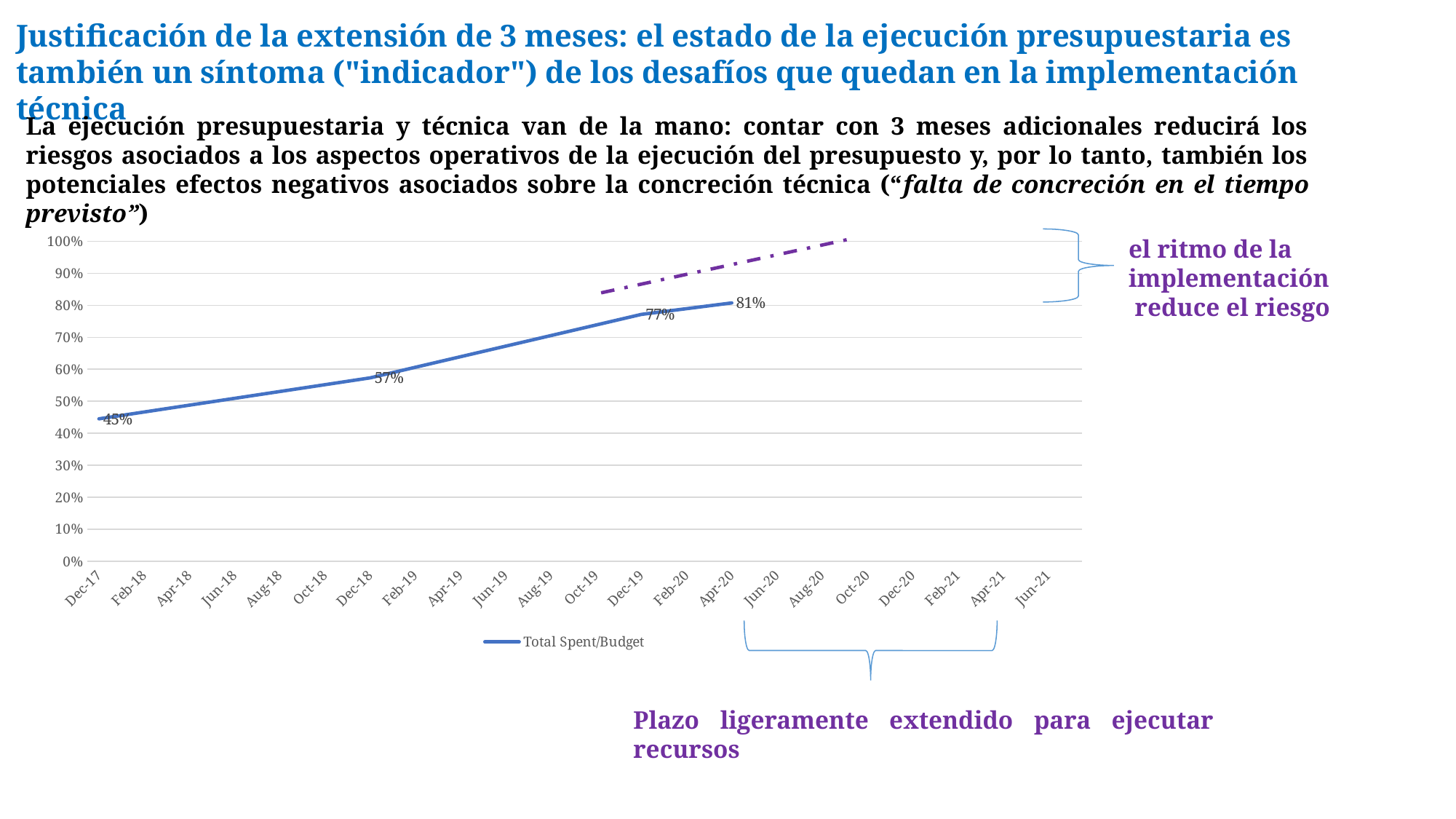
What is the value of Total Spent/Budget at Dec-17? 45% What type of chart is shown on the slide? line chart Which labeled point has the highest Total Spent/Budget value? Apr-20 Which labeled point has the lowest Total Spent/Budget value? Dec-17 What is the name of the series shown in the legend? Total Spent/Budget What is the value of Total Spent/Budget at Apr-20? 81% What is the difference between the Total Spent/Budget values at Apr-20 and Dec-17? 36% How many series does the legend list? 1 Does the Total Spent/Budget line rise or fall from Dec-17 to Apr-20? rise What is the value of Total Spent/Budget at Dec-18? 57% What is the value of Total Spent/Budget at Dec-19? 77% What is the difference between the Total Spent/Budget values at Dec-19 and Dec-18? 20%